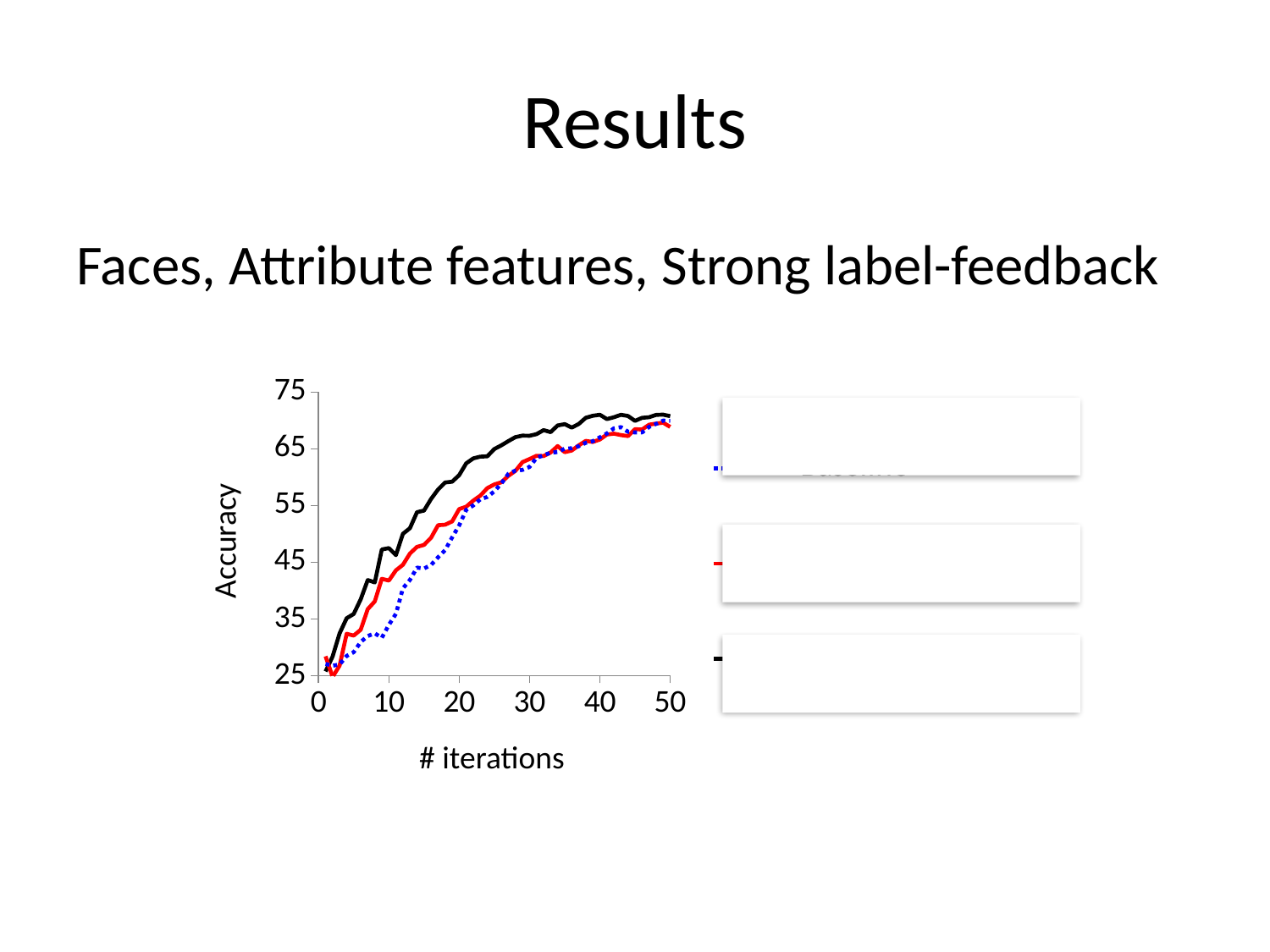
Is the value of the black solid line at 20 iterations greater or less than 55? greater Do the plotted accuracy values generally rise or fall as the number of iterations increases? rise What is the label of the x-axis of the chart? # iterations At 10 iterations, which line has the higher value, the black solid line or the blue dotted line? black solid line What kind of chart is shown on the slide? line chart How many lines are plotted on the chart? 3 What is the highest value shown on the y-axis of the chart? 75 Is the value of the red solid line at 10 iterations greater or less than 45? less At 20 iterations, which of the three lines has the highest value? black solid line Is the value of the black solid line at 50 iterations greater or less than 65? greater What is the label of the y-axis of the chart? Accuracy